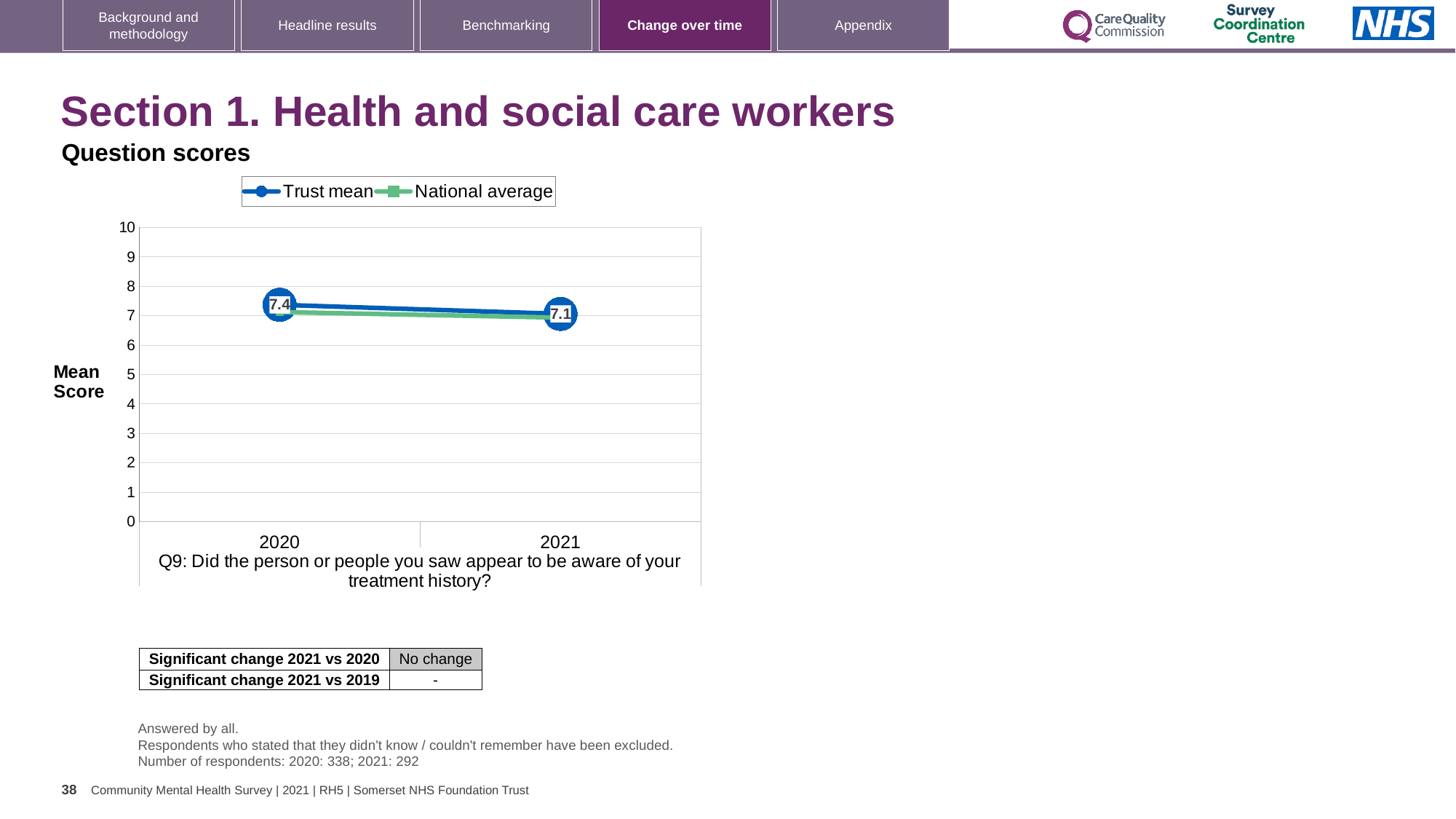
How many years are plotted on the x axis? 2 By how much did the Trust mean change from 2020 to 2021? 0.3 Is the National average for 2020 greater or less than 5? greater Which year has the higher Trust mean, 2020 or 2021? 2020 What is the Trust mean for 2021? 7.1 How many series does the legend list? 2 What are the two series named in the legend? Trust mean and National average What kind of chart is shown? line chart Does the Trust mean rise or fall from 2020 to 2021? fall Is the National average for 2021 greater or less than 8? less What is the label on the y axis? Mean Score What is the Trust mean for 2020? 7.4